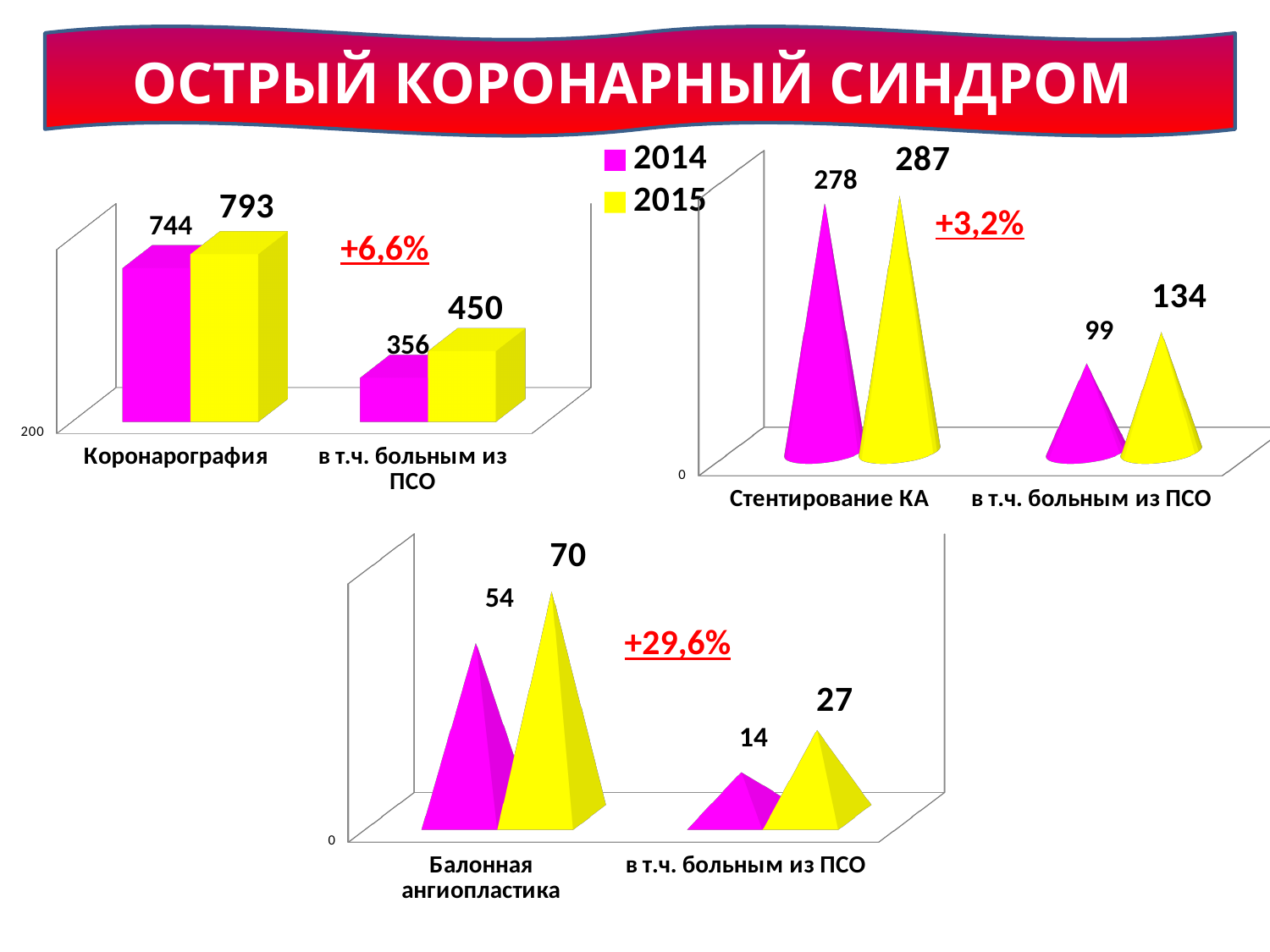
In the top-right chart, what is the 2015 value for в т.ч. больным из ПСО? 134 What percentage change is printed in red on the top-right chart? +3,2% In the top-right chart, which is larger for в т.ч. больным из ПСО: the 2014 value or the 2015 value? 2015 In the top-left chart, what is the difference between the 2015 and 2014 values for Коронарография? 49 In the bottom chart, what is the difference between the 2015 and 2014 values for в т.ч. больным из ПСО? 13 In the bottom chart, which category and year has the lowest value? в т.ч. больным из ПСО, 2014 In the bottom chart, what is the 2014 value for в т.ч. больным из ПСО? 14 In the bottom chart, what is the 2015 value for Балонная ангиопластика? 70 In the top-right chart, what is the 2014 value for Стентирование КА? 278 How many series does the legend list? 2 In the top-left chart, what is the 2014 value for в т.ч. больным из ПСО? 356 In the top-left chart, what is the 2015 value for Коронарография? 793